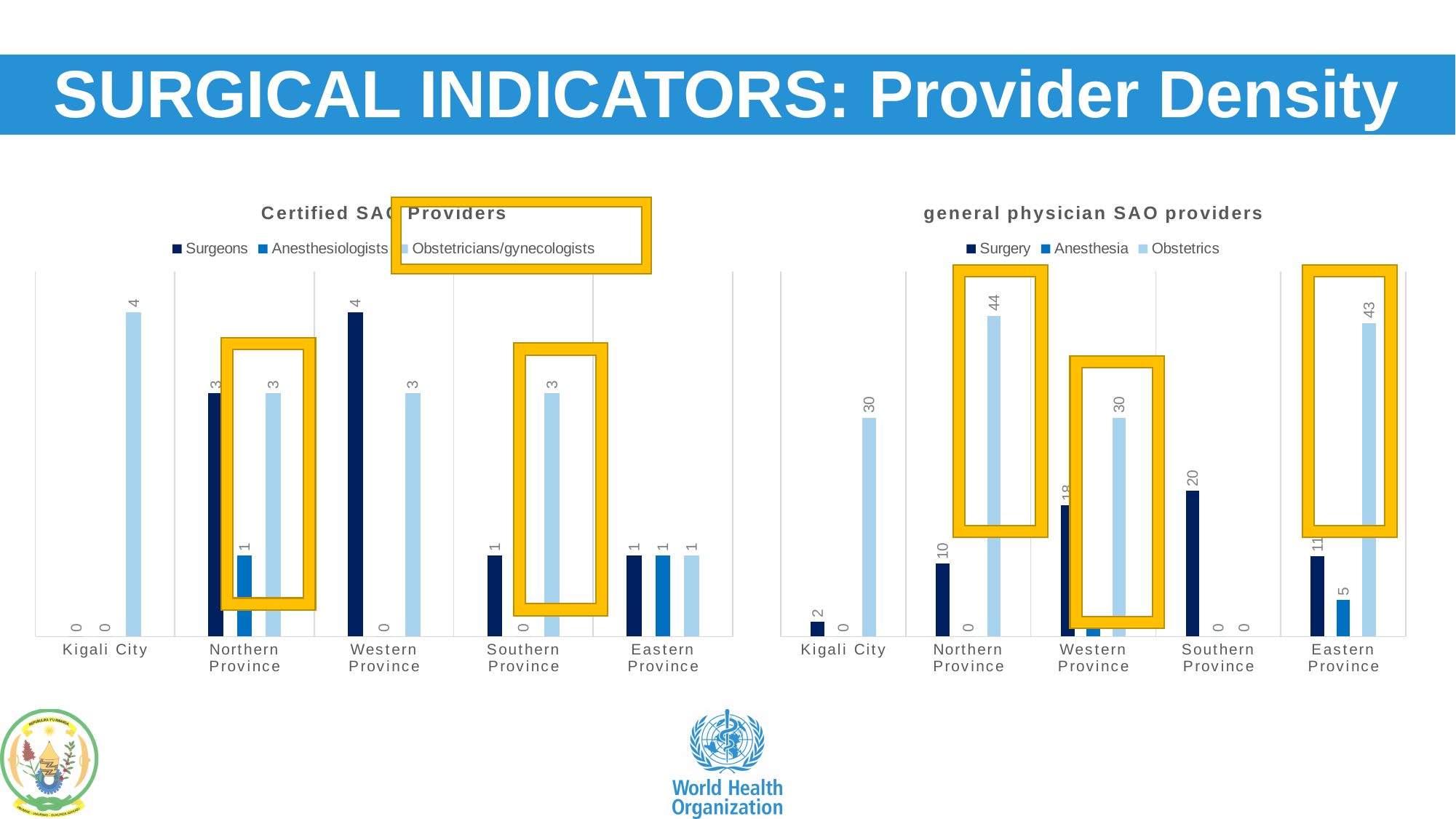
In the 'general physician SAO providers' chart, which province has the highest Obstetrics value? Northern Province In the 'Certified SAO Providers' chart, how many Surgeons are in Western Province? 4 In the 'Certified SAO Providers' chart, how many Anesthesiologists are in Northern Province? 1 How many series does the legend of the 'general physician SAO providers' chart list? 3 In the 'general physician SAO providers' chart, what is the difference between the Obstetrics values for Northern Province and Kigali City? 14 In the 'Certified SAO Providers' chart, how many Obstetricians/gynecologists are in Kigali City? 4 In the 'Certified SAO Providers' chart, which province has the most Surgeons? Western Province In the 'general physician SAO providers' chart, what is the Obstetrics value for Northern Province? 44 In the 'general physician SAO providers' chart, what is the Surgery value for Southern Province? 20 In the 'general physician SAO providers' chart, what is the Anesthesia value for Eastern Province? 5 How many provinces/categories are shown on the x axis of the 'Certified SAO Providers' chart? 5 In the 'general physician SAO providers' chart, which is larger: the Surgery value for Western Province or for Northern Province? Western Province